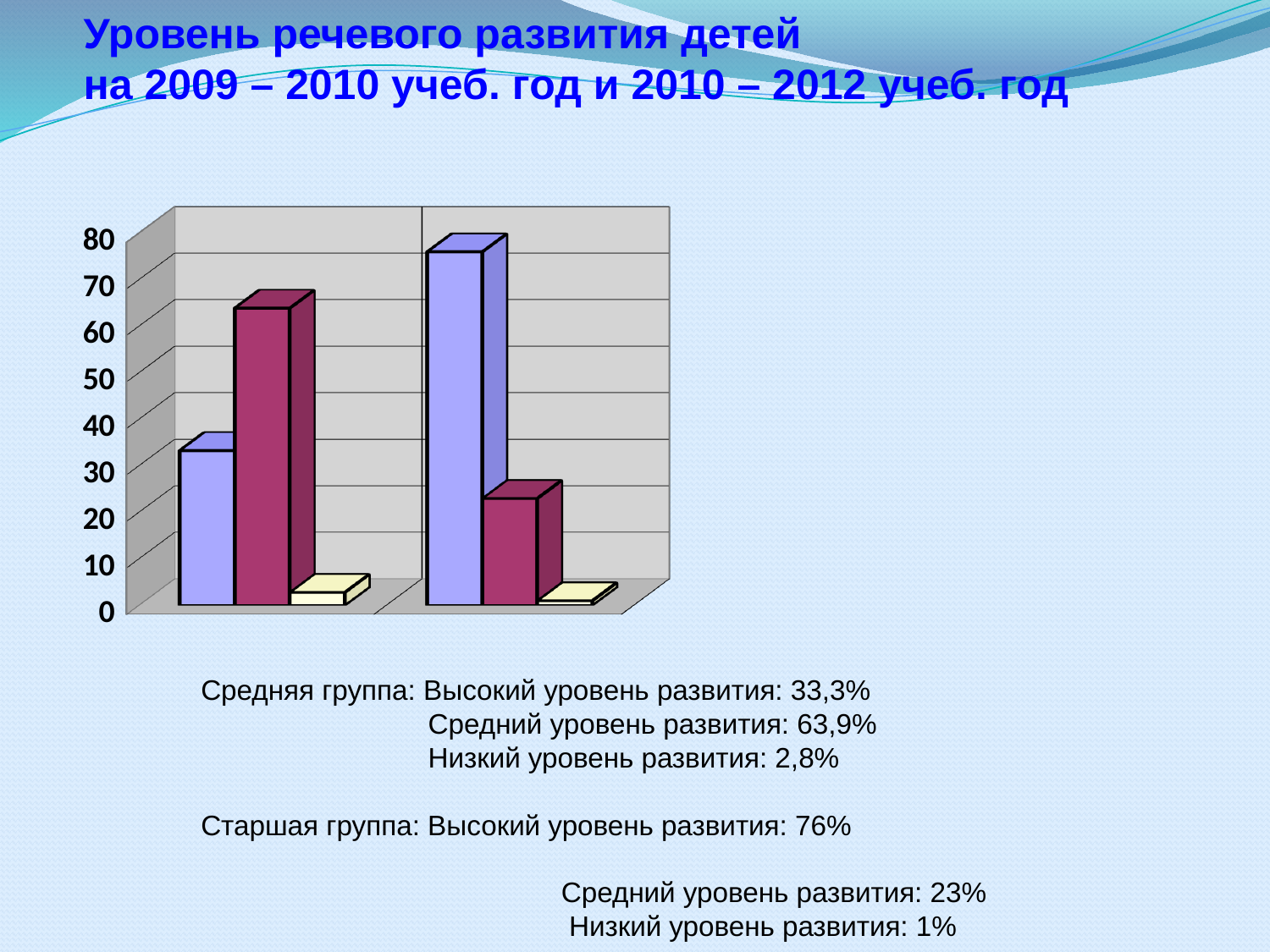
How many bars are plotted in the chart? 6 According to the slide, what is the low level of development (Низкий уровень развития) for the Старшая группа? 1% What is the difference between the high level of development for the Старшая группа (76%) and the medium level for the Старшая группа (23%)? 53% According to the slide, what is the high level of development (Высокий уровень развития) for the Старшая группа? 76% Which bar is the tallest in the chart? the blue bar in the second group (Старшая группа, высокий уровень развития) Is the value of the tallest blue bar in the chart greater or less than 70? greater What is the highest value shown on the vertical axis of the chart? 80 According to the slide, what is the medium level of development (Средний уровень развития) for the Средняя группа? 63,9% According to the slide, what is the high level of development (Высокий уровень развития) for the Средняя группа? 33,3% Is the value of the magenta bar in the second group greater or less than 30? less What kind of chart is shown on the slide? bar chart How many groups of bars does the chart show? 2